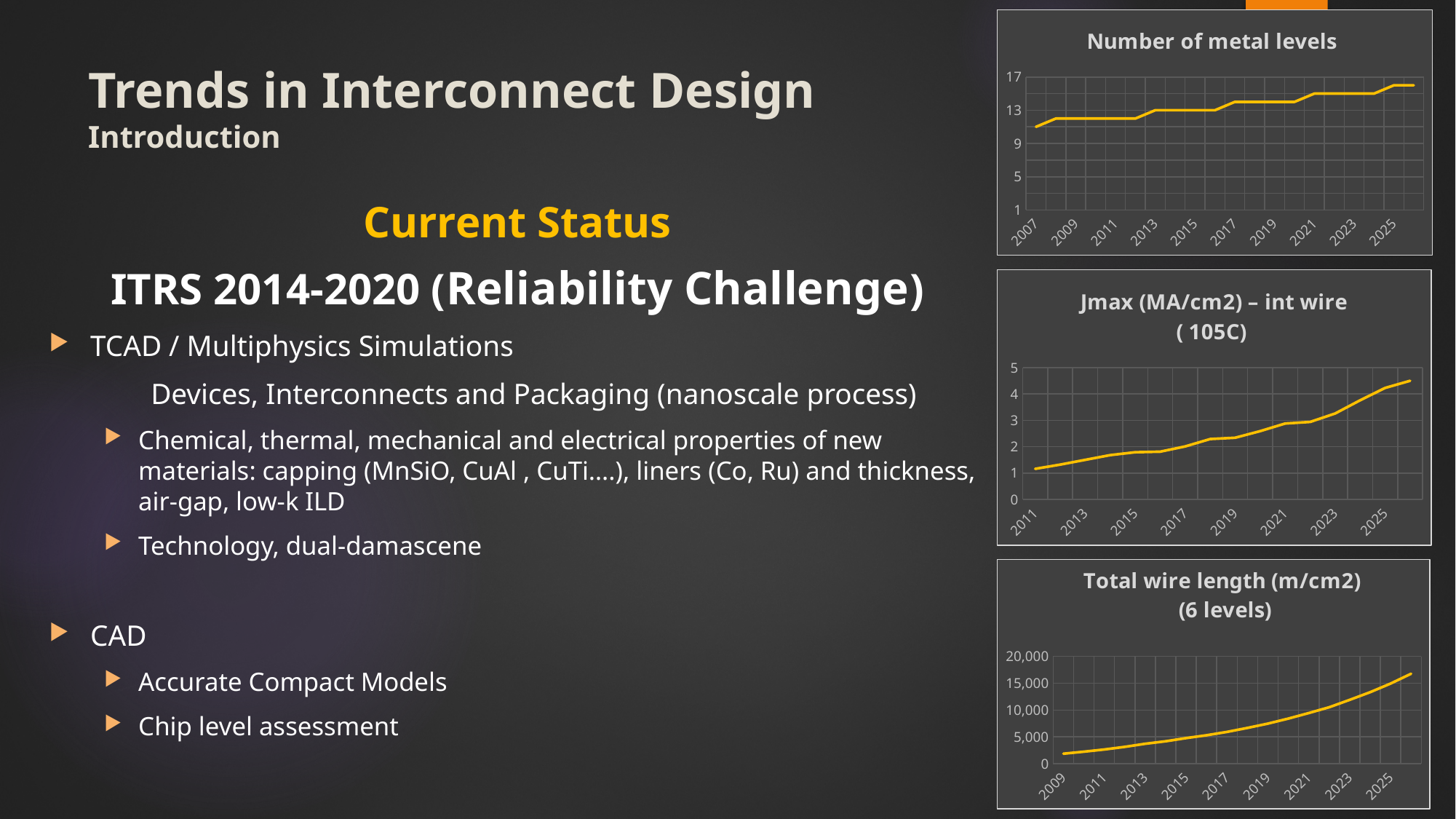
In the 'Number of metal levels' chart, is the value for 2007 greater or less than 9? greater In the 'Jmax (MA/cm2) – int wire (105C)' chart, is the value for 2011 greater or less than 2? less In the 'Number of metal levels' chart, is the value for 2025 greater or less than 13? greater What temperature is stated in the title of the middle chart on the slide? 105C In the 'Jmax (MA/cm2) – int wire (105C)' chart, do the values rise or fall along the x axis? rise How many metal levels does the title of the bottom chart ('Total wire length') refer to? 6 levels What kind of chart is the 'Number of metal levels' chart? line chart In the 'Number of metal levels' chart, do the values rise or fall from 2007 to 2025? rise In the 'Total wire length (m/cm2) (6 levels)' chart, do the values rise or fall from 2009 to 2025? rise